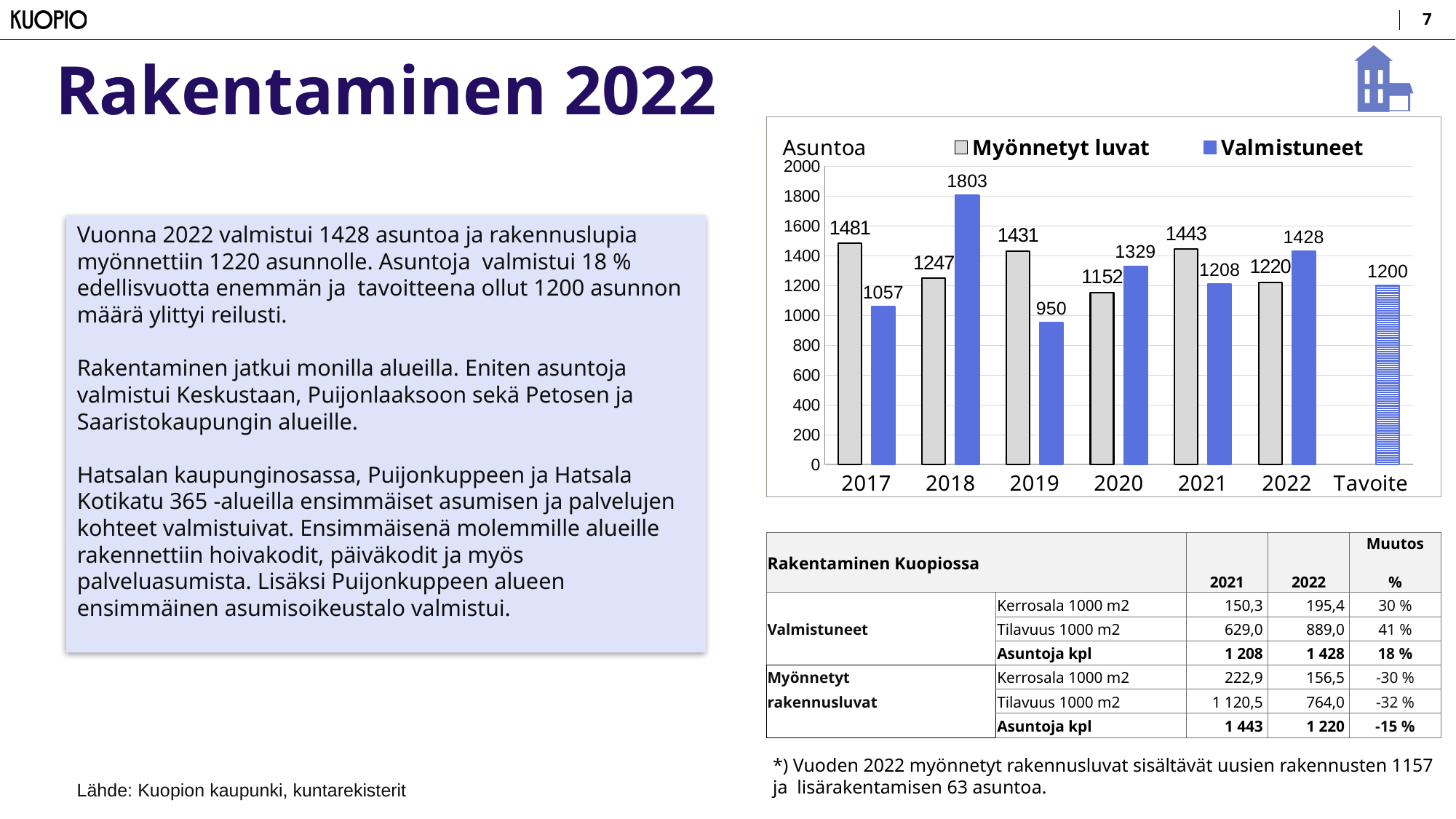
What is the value shown for Tavoite? 1200 In which year is Valmistuneet lowest? 2019 What is the label shown at the top left of the chart above the y axis? Asuntoa In which year is Myönnetyt luvat highest? 2017 In which year is Valmistuneet highest? 2018 What is the difference between Valmistuneet and Myönnetyt luvat in 2022? 208 What is the value of Valmistuneet for 2022? 1428 What type of chart is shown on the slide? bar chart Which is larger in 2020, Myönnetyt luvat or Valmistuneet? Valmistuneet How many series does the chart legend list? 2 What is the value of Myönnetyt luvat for 2019? 1431 How many categories are shown on the x axis of the chart? 7